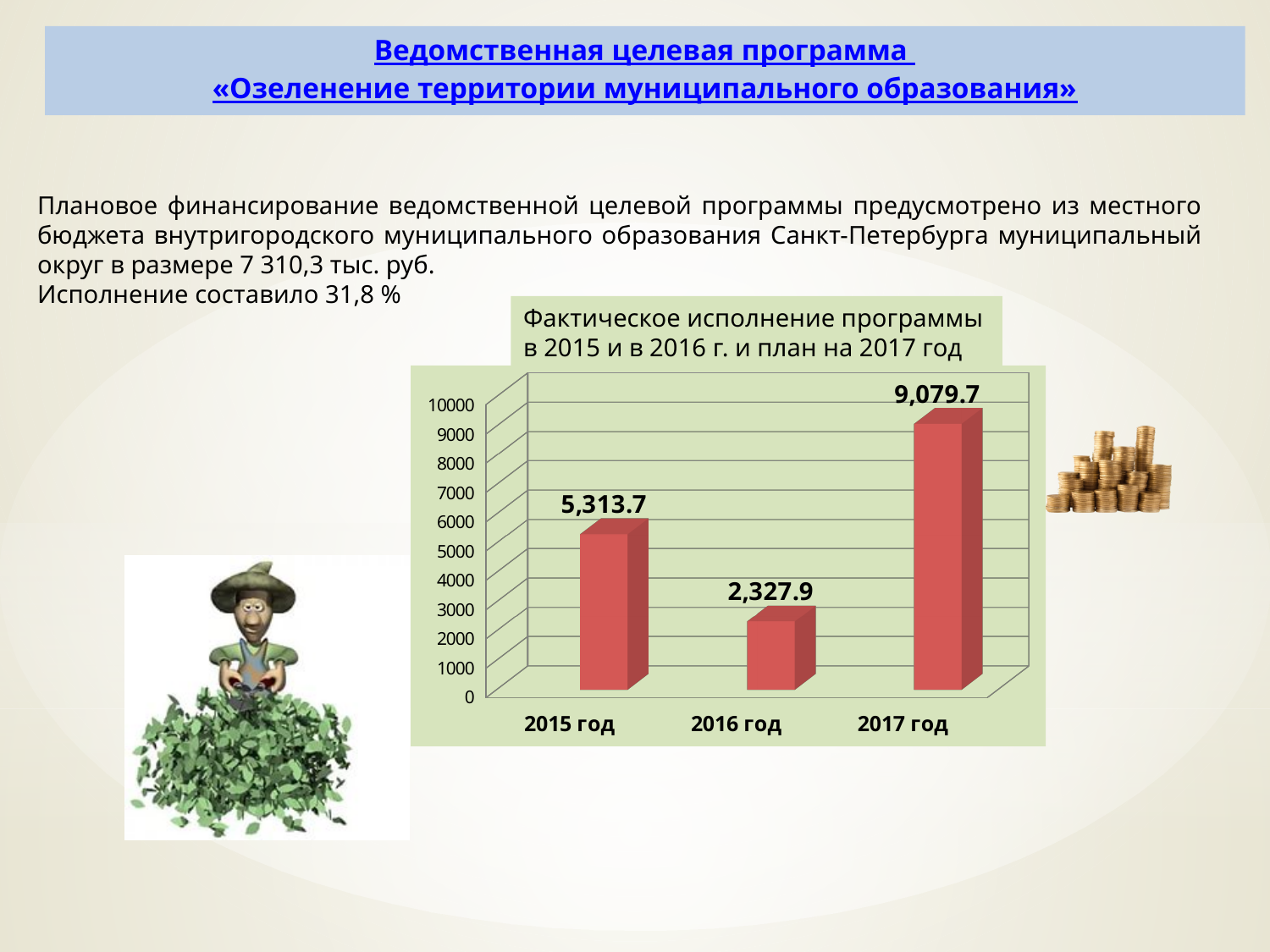
Which year has the highest value? 2017 год How many years are shown on the chart? 3 Which year has the lowest value? 2016 год What is the difference between the values for 2015 год and 2016 год? 2,985.8 Does the value rise or fall from 2016 год to 2017 год? rise Which is larger, the value for 2015 год or the value for 2016 год? 2015 год What is the value for 2017 год? 9,079.7 What is the value for 2016 год? 2,327.9 What is the value for 2015 год? 5,313.7 What is the difference between the values for 2017 год and 2015 год? 3,766.0 What kind of chart is shown on the slide? bar chart Is the value for 2017 год greater or less than 8000? greater